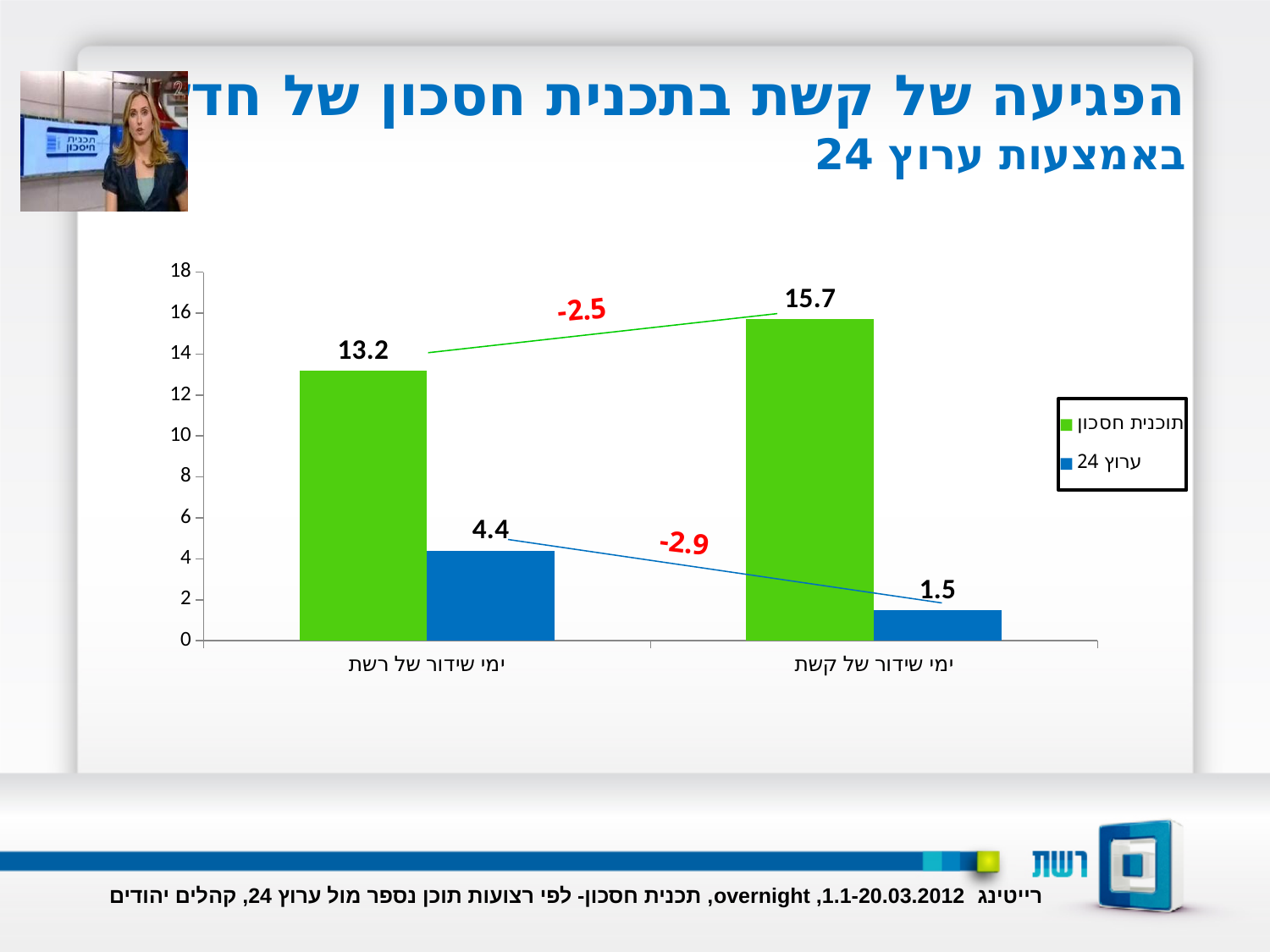
What kind of chart is shown on the slide? bar chart What is the value of תוכנית חסכון for ימי שידור של רשת? 13.2 Which category has the highest value for תוכנית חסכון? ימי שידור של קשת Which category has the lowest value for ערוץ 24? ימי שידור של קשת How many series does the legend list? 2 How many categories are shown on the x axis? 2 What is the value of ערוץ 24 for ימי שידור של רשת? 4.4 What is the value of ערוץ 24 for ימי שידור של קשת? 1.5 Which is larger: תוכנית חסכון for ימי שידור של רשת or ערוץ 24 for ימי שידור של רשת? תוכנית חסכון What is the difference between the ערוץ 24 values for ימי שידור של רשת and ימי שידור של קשת? 2.9 What is the difference between the תוכנית חסכון values for ימי שידור של קשת and ימי שידור של רשת? 2.5 What is the value of תוכנית חסכון for ימי שידור של קשת? 15.7